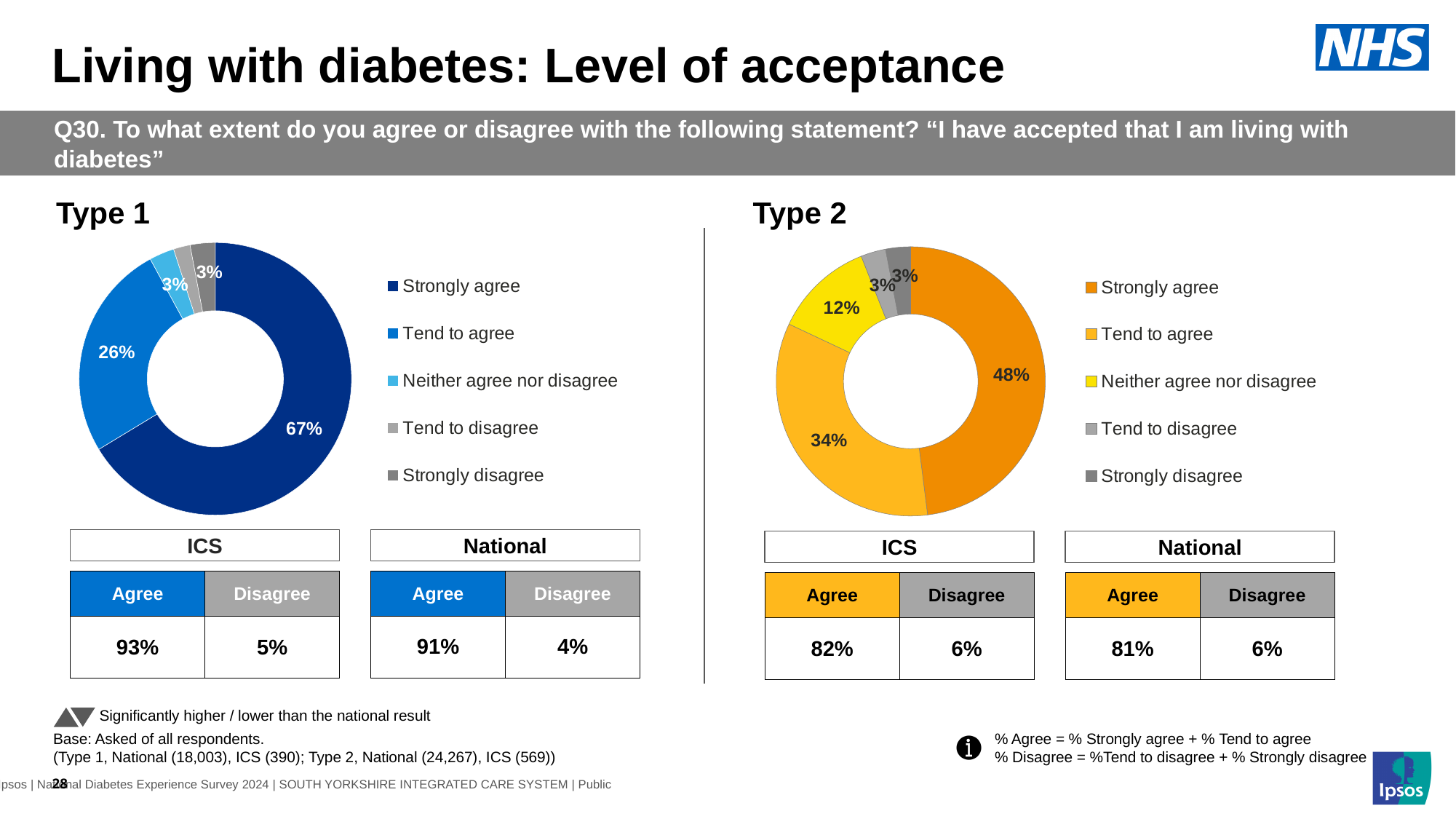
In the Type 1 chart, what percentage of respondents strongly agree? 67% In the Type 2 chart, what percentage of respondents tend to agree? 34% In the Type 2 chart, which response category has the largest share? Strongly agree What kind of chart is used for Type 1? Donut (pie) chart In the Type 2 chart, what colour represents Neither agree nor disagree? Yellow Which is larger: the Strongly agree share in the Type 1 chart or the Strongly agree share in the Type 2 chart? Type 1 In the Type 1 chart, what is the difference in percentage points between Strongly agree and Tend to agree? 41 percentage points In the Type 1 chart, what percentage of respondents tend to agree? 26% How many response categories does the legend of the Type 2 chart list? 5 In the Type 1 chart, which response category has the largest share? Strongly agree In the Type 2 chart, what percentage neither agree nor disagree? 12% In the Type 2 chart, what is the difference in percentage points between Strongly agree and Tend to agree? 14 percentage points